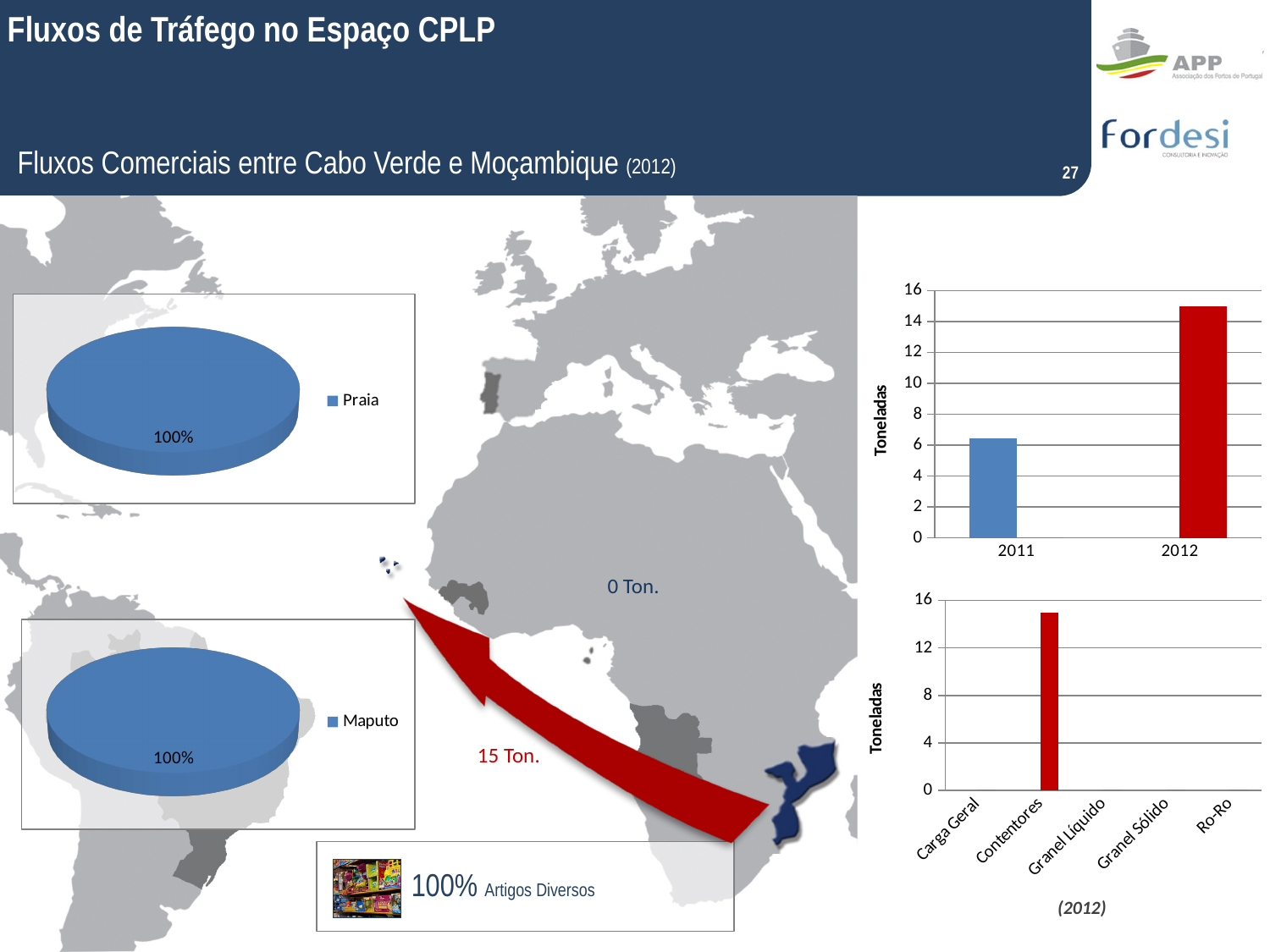
In the top-right bar chart by year, do the values rise or fall from 2011 to 2012? rise In the top-right bar chart by year, which year has the higher value? 2012 In the bottom-right bar chart by cargo type (2012), how many categories are shown on the x axis? 5 In the bottom-right bar chart by cargo type (2012), which category has the highest value? Contentores What kind of chart is the bottom-right chart by cargo type (2012)? bar chart What is the y-axis label of the top-right bar chart by year? Toneladas In the top-right bar chart by year, is the value for 2011 greater or less than 8? less In the top-left pie chart, what share does Praia have? 100% In the bottom-right bar chart by cargo type (2012), is the value for Contentores greater or less than 12? greater In the top-right bar chart by year, how many years are shown on the x axis? 2 In the bottom-left pie chart, what is the only legend entry? Maputo In the top-right bar chart by year, is the value for 2012 greater or less than 12? greater